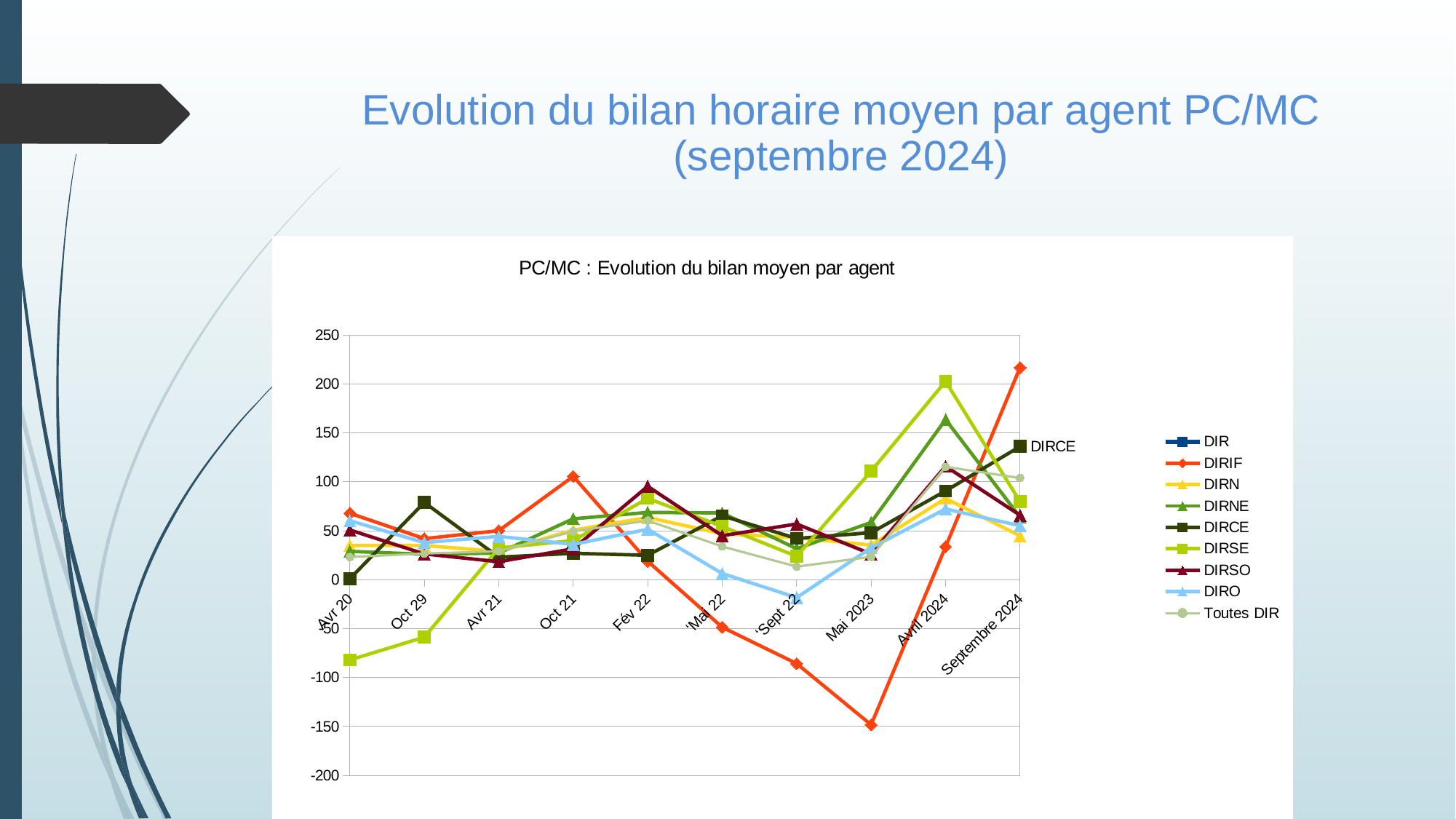
Is the value for DIRCE at Septembre 2024 greater or less than 100? greater Is the value for DIRIF at Septembre 2024 greater or less than 200? greater Is the value for DIRIF at Mai 2023 greater or less than -100? less Which series has the highest value at Avril 2024? DIRSE Which series has the highest value at Septembre 2024? DIRIF How many points are plotted along the x axis for each series? 10 How many series does the legend list? 9 Which series has the lowest value at Avr 20? DIRSE Which series has the lowest value at Mai 2023? DIRIF Does the DIRIF series rise or fall from Mai 2023 to Septembre 2024? rise What kind of chart is shown on the slide? line chart What is the title of the chart? PC/MC : Evolution du bilan moyen par agent